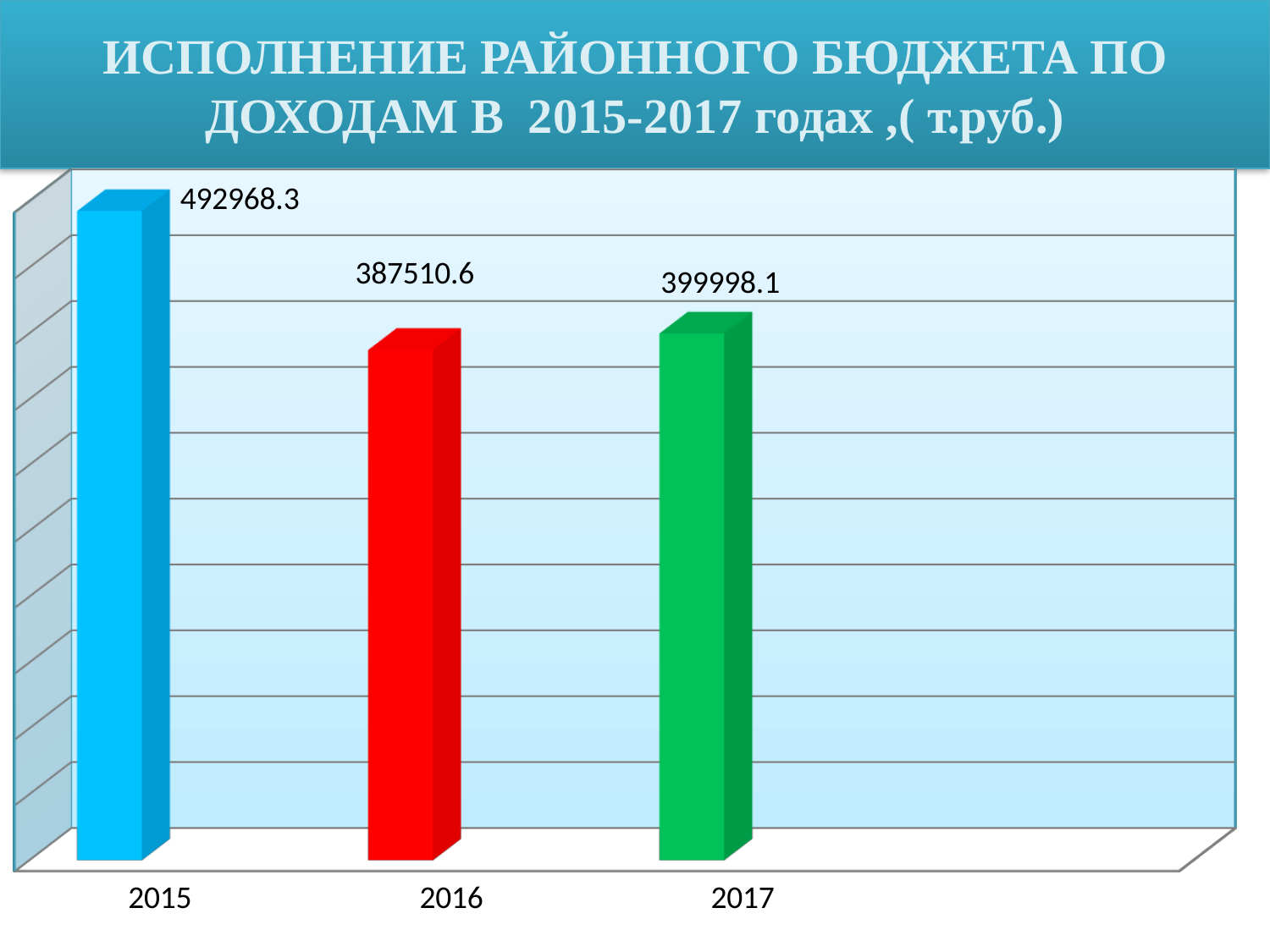
Which is larger, the value for 2016 or the value for 2017? 2017 What is the value for 2016? 387510.6 What is the difference between the values for 2017 and 2016? 12487.5 What is the value for 2017? 399998.1 How many years are shown on the chart? 3 What kind of chart is shown on the slide? Bar chart Which year has the lowest value? 2016 What colour is the bar for 2017? Green What is the value for 2015? 492968.3 Which year has the highest value? 2015 Does the value rise or fall from 2015 to 2016? Fall What is the difference between the values for 2015 and 2016? 105457.7